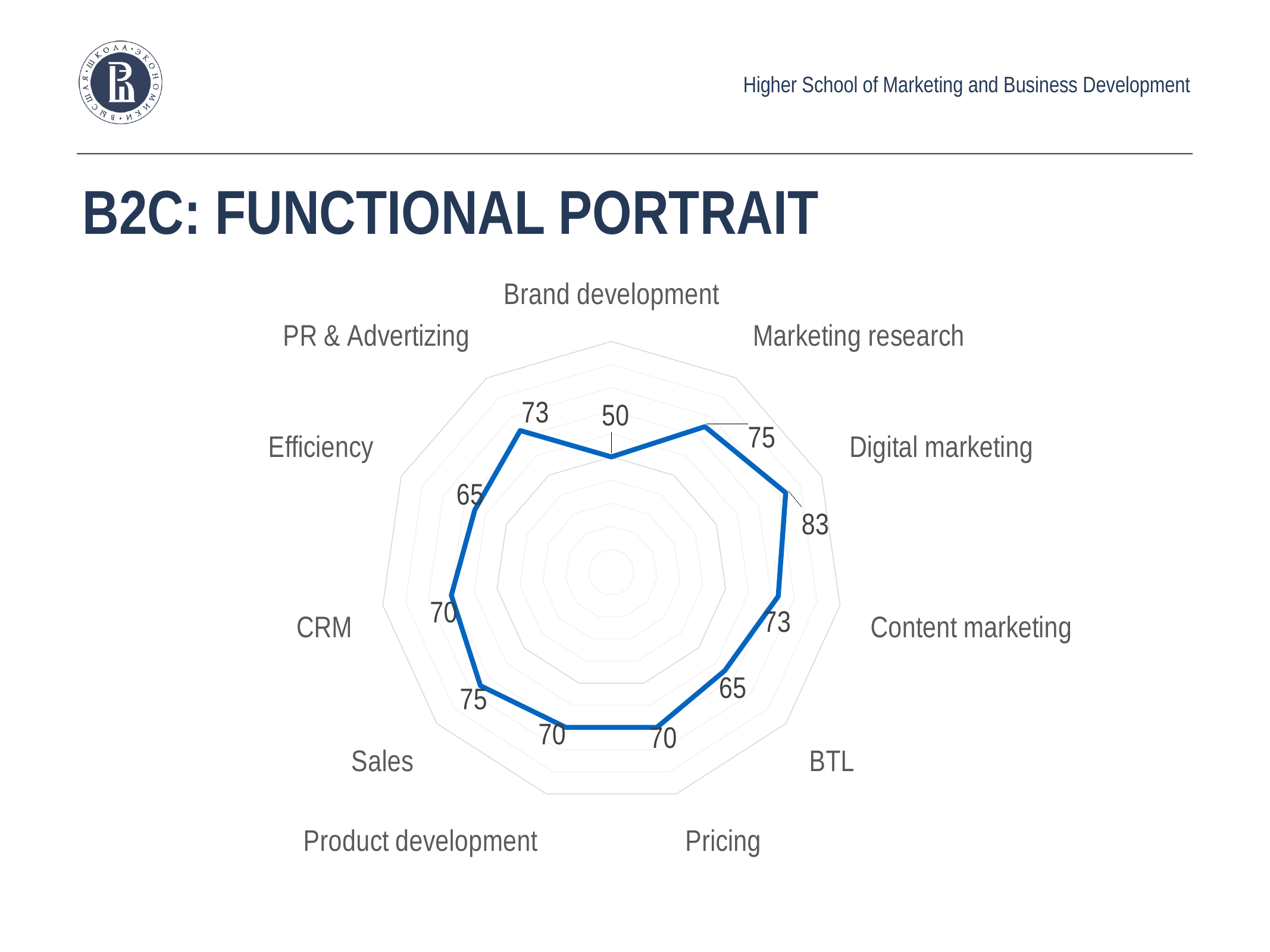
Which is larger, the value for Marketing research or the value for Efficiency? Marketing research Which category has the highest value? Digital marketing What is the value for PR & Advertizing? 73 What kind of chart is shown on the slide? Radar chart How many categories are plotted on the chart? 11 What is the title of the slide? B2C: FUNCTIONAL PORTRAIT Which category has the lowest value? Brand development What is the value for BTL? 65 What is the value for Sales? 75 What is the difference between the values for Digital marketing and Brand development? 33 What is the value for Digital marketing? 83 What is the value for Brand development? 50